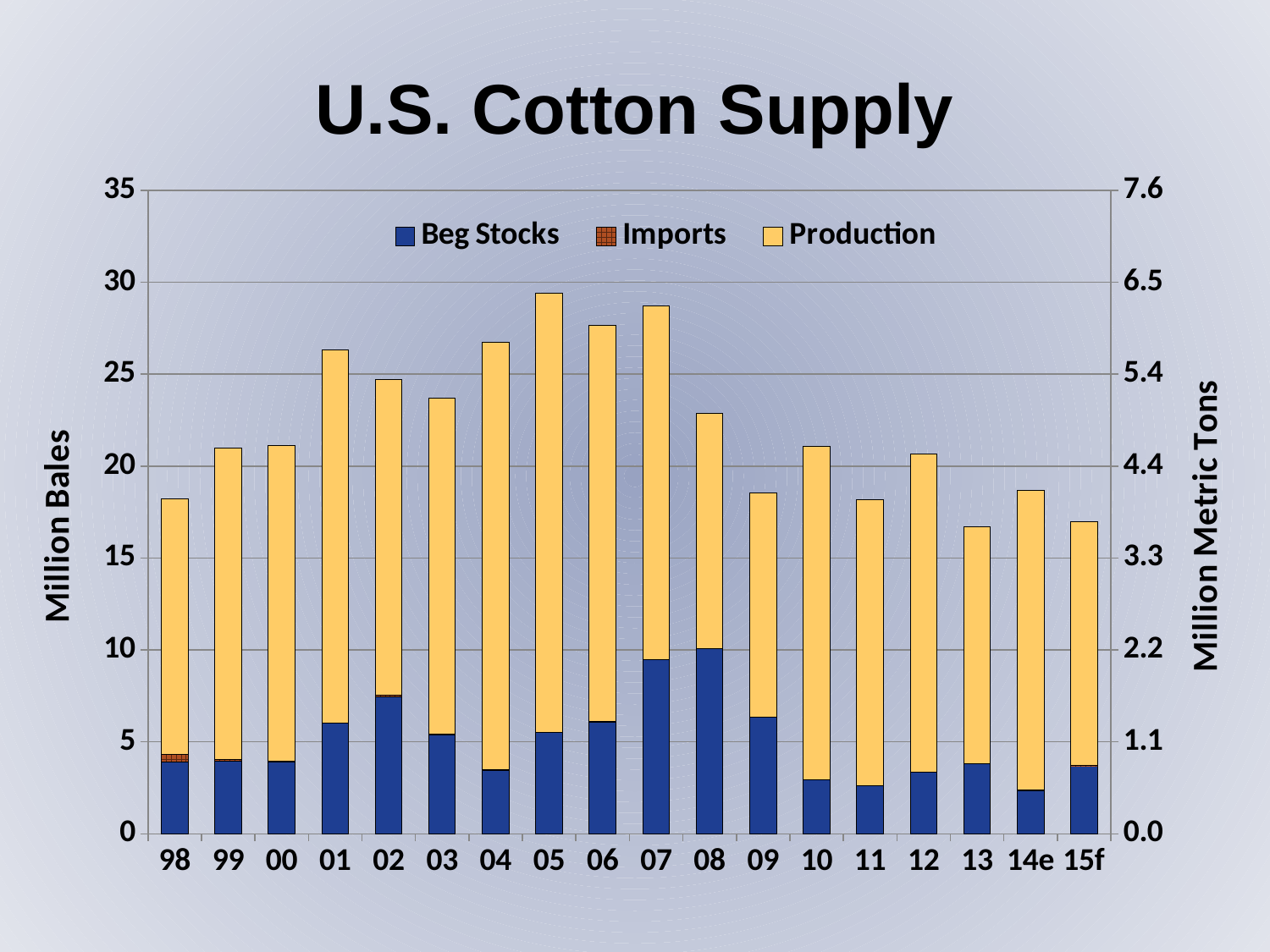
Which year has the taller total bar, 01 or 02? 01 What is the label on the right-hand vertical axis? Million Metric Tons From 98 to 01, do the total bar heights rise or fall? rise What is the title of the chart? U.S. Cotton Supply Is the total bar height for 05 greater or less than 25 million bales? greater How many series does the legend list? 3 Which year has the tallest total bar? 05 Is the Beg Stocks value for 07 greater or less than 5 million bales? greater Which year has the largest Beg Stocks segment? 08 What type of chart is shown on the slide? Stacked bar chart Is the total bar height for 98 greater or less than 20 million bales? less How many years (categories) are shown along the x axis? 18